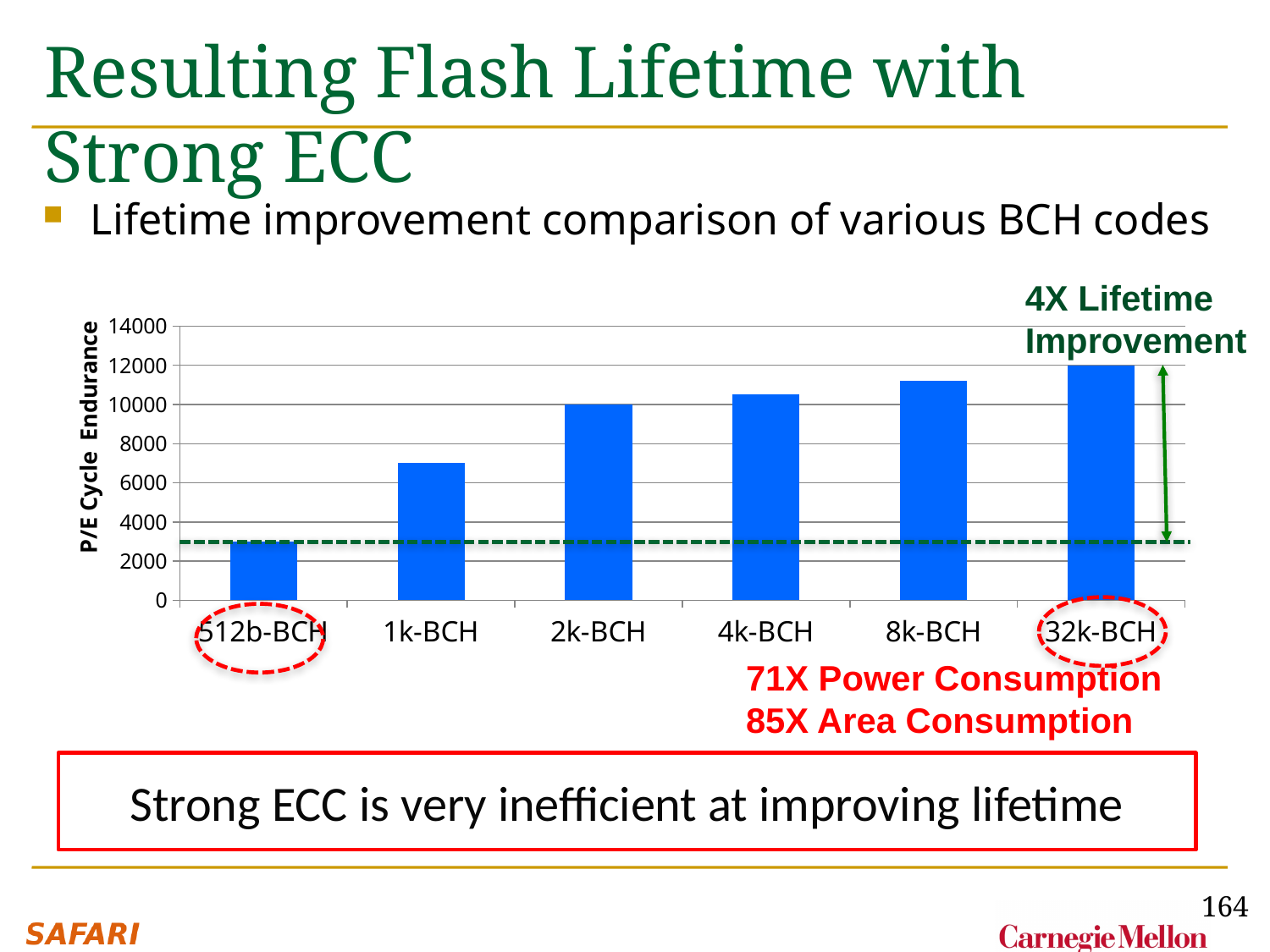
Do the bar values rise or fall from 512b-BCH to 32k-BCH along the x axis? rise Is the value for 8k-BCH greater or less than 12000? less What kind of chart is shown on the slide? bar chart Which BCH code has the lowest P/E cycle endurance? 512b-BCH What is the P/E cycle endurance for 2k-BCH? 10000 Which BCH code has the highest P/E cycle endurance? 32k-BCH Is the value for 512b-BCH greater or less than 4000? less What is the P/E cycle endurance for 32k-BCH? 12000 How many BCH code categories are plotted on the x axis? 6 What is the label on the y axis of the chart? P/E Cycle Endurance Which has a larger P/E cycle endurance, 1k-BCH or 2k-BCH? 2k-BCH Is the value for 1k-BCH greater or less than 6000? greater